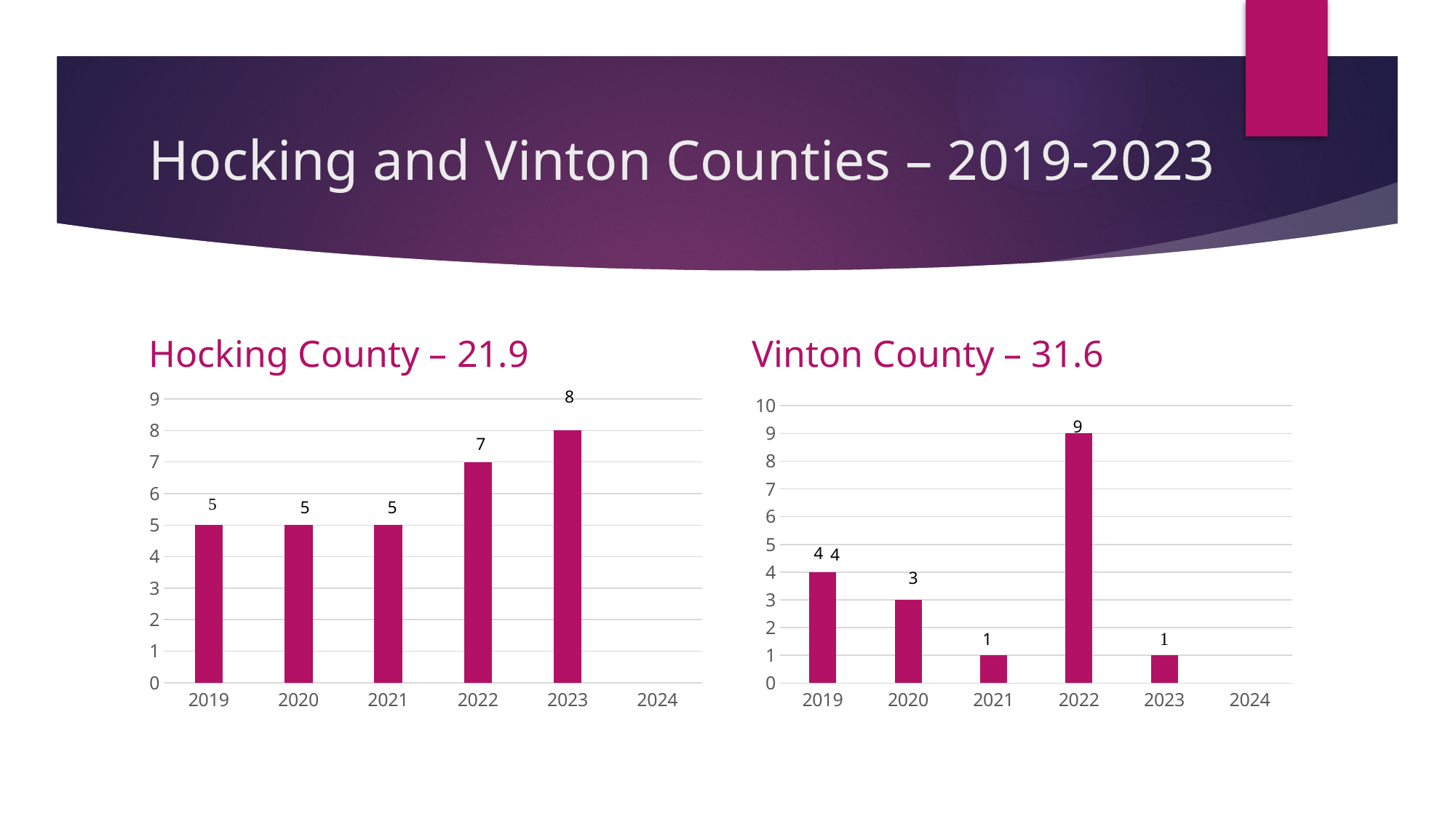
In the Vinton County chart, what is the difference between the values for 2022 and 2020? 6 In the Hocking County chart, what is the value for 2023? 8 In the Vinton County chart, what is the value for 2020? 3 In the Hocking County chart, which year has the highest value? 2023 In the Vinton County chart, which year has the highest value? 2022 In the Hocking County chart, what is the difference between the values for 2023 and 2019? 3 In the Vinton County chart, which is larger, the value for 2019 or the value for 2023? 2019 What kind of chart is the Vinton County chart? Bar chart In the Vinton County chart, what is the value for 2022? 9 What is the title of the chart on the right side of the slide? Vinton County – 31.6 How many bars are plotted in the Hocking County chart? 5 In the Hocking County chart, what is the value for 2022? 7